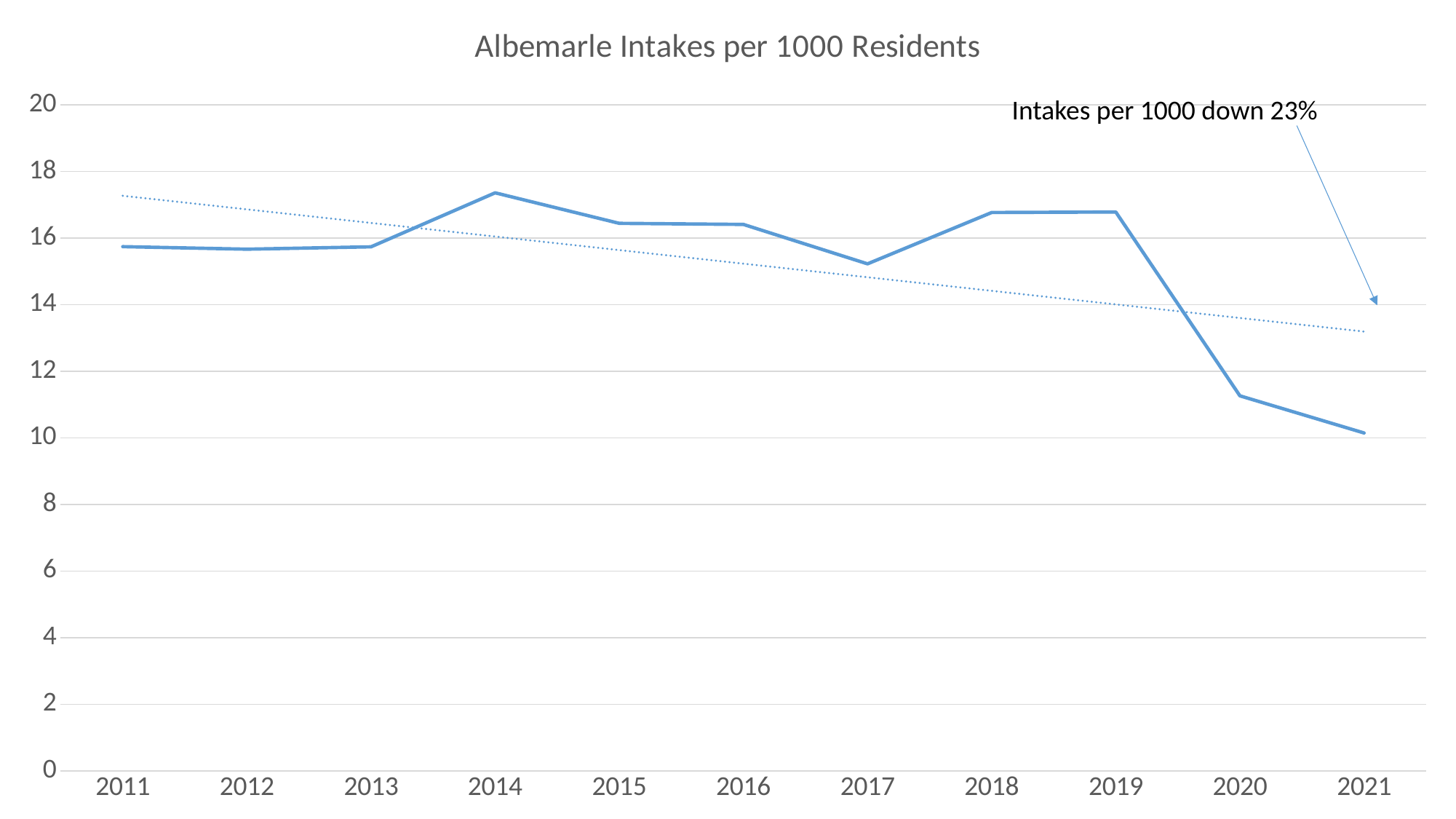
Is the value for 2021 greater or less than 12? less Which year has the highest intakes per 1000 residents? 2014 Is the value for 2017 greater or less than 16? less Is the value for 2014 greater or less than 16? greater Which year has the lowest intakes per 1000 residents? 2021 How many years are plotted along the x axis? 11 Which year has the larger value, 2019 or 2020? 2019 What is the title of the chart? Albemarle Intakes per 1000 Residents What does the text annotation on the chart say? Intakes per 1000 down 23% Overall, do the intakes per 1000 residents rise or fall from 2011 to 2021? Fall What kind of chart is shown on the slide? Line chart